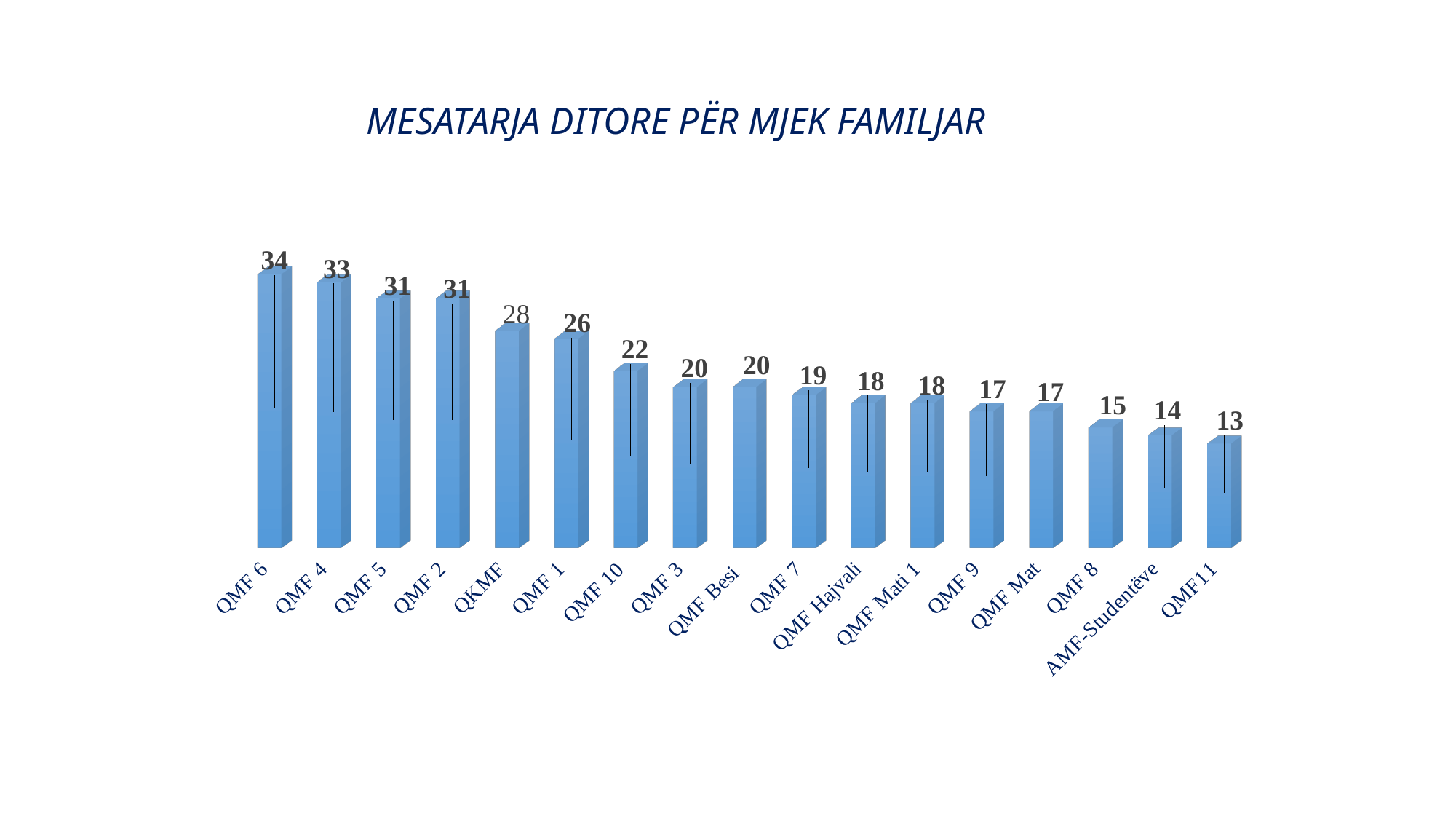
What is the difference between the values for QMF 1 and QMF 10? 4 What is the value for QMF Hajvali? 18 What is the value for QMF 6? 34 What is the difference between the values for QMF 6 and QMF11? 21 What is the value for QKMF? 28 Which category has the highest value? QMF 6 How many categories are shown on the chart? 17 What is the title of the chart? MESATARJA DITORE PËR MJEK FAMILJAR Which is larger, the value for QMF 4 or the value for QMF 2? QMF 4 What kind of chart is shown on the slide? Bar chart What is the value for AMF-Studentëve? 14 Which category has the lowest value? QMF11